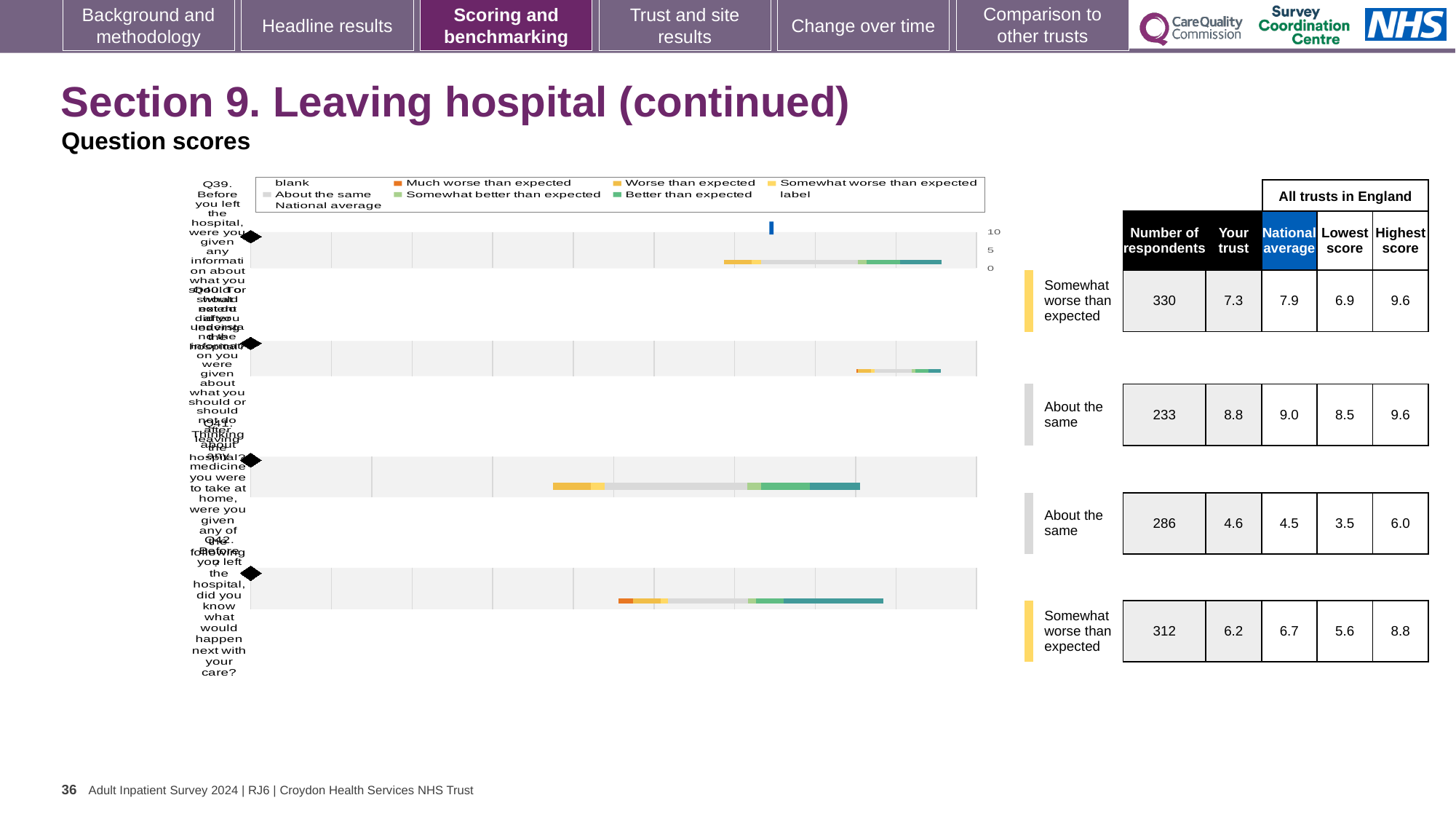
What kind of chart is shown on the left of the slide? bar chart How many question rows (bars) does the chart on the left show? 4 Which row of the chart has the highest 'Your trust' score? The second row (8.8) How many respondents are listed for Q39 (the first row of the chart)? 330 Which row of the chart has the lowest 'Your trust' score? The third row (4.6) For Q39 (the first row), which is larger: the 'Your trust' score or the national average? National average What is the highest score across all trusts in England for Q42 (the last row of the chart)? 8.8 For Q42 (the last row), what is the difference between the highest score and the lowest score across all trusts in England? 3.2 What is the 'Your trust' score for Q42 (the last row of the chart)? 6.2 What is the national average score for Q39 (the first row of the chart)? 7.9 What is the 'Your trust' score for Q39 (the first row of the chart)? 7.3 What benchmark category is shown for Q39 (the first row of the chart)? Somewhat worse than expected